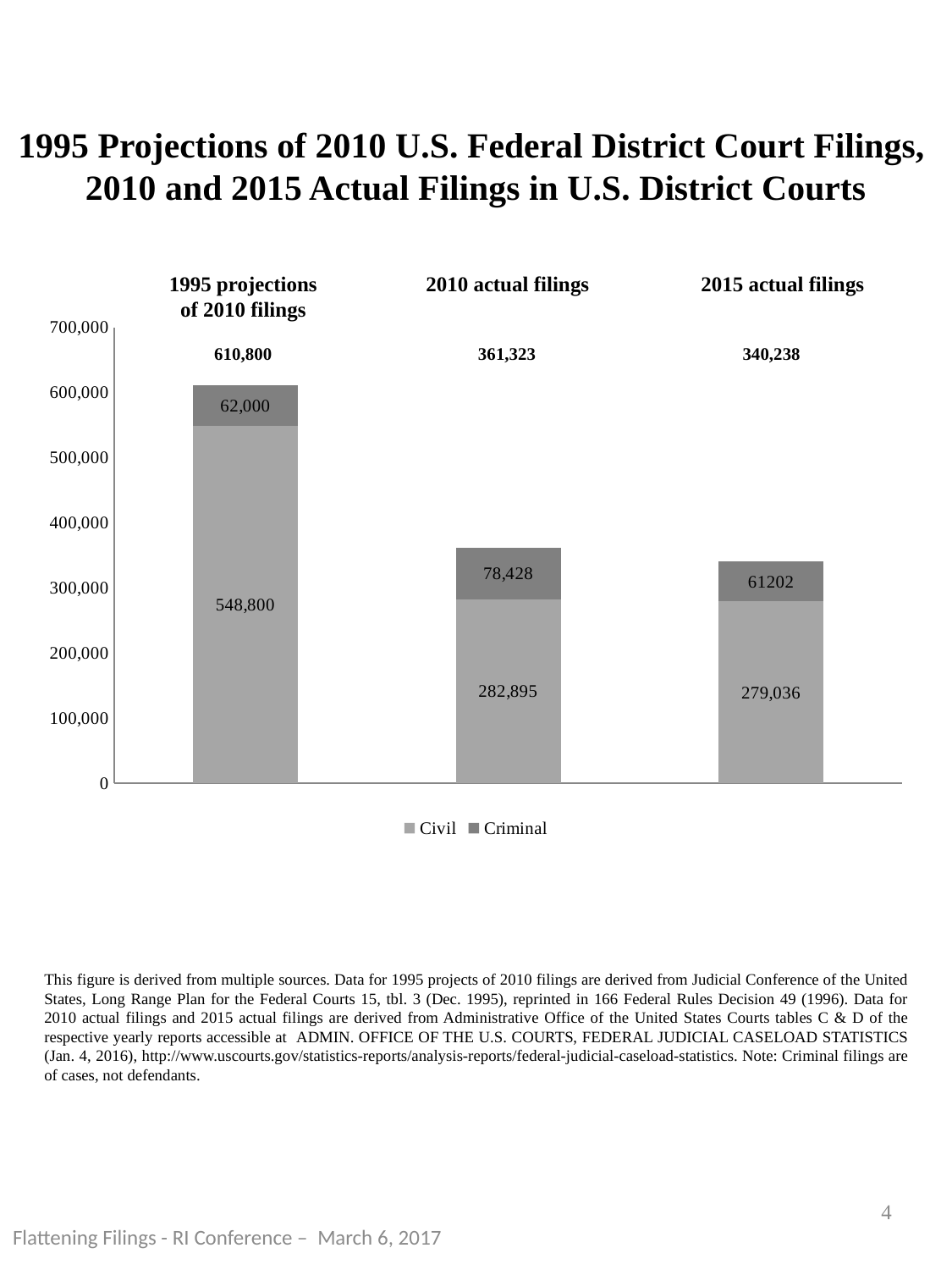
What is the Civil value for the 1995 projections of 2010 filings? 548,800 How many series does the legend list? 2 What is the total of the stacked bar for 2010 actual filings? 361,323 What is the difference between the Civil values for 2010 actual filings and 2015 actual filings? 3,859 What is the Civil value for 2015 actual filings? 279,036 What is the Criminal value for 2010 actual filings? 78,428 Which category has the highest Civil value? 1995 projections of 2010 filings How many categories are shown on the x axis? 3 What is the total of the stacked bar for 2015 actual filings? 340,238 What kind of chart is shown on the slide? Stacked bar chart Which category has the lowest Criminal value? 2015 actual filings Which is larger, the Criminal value for 1995 projections of 2010 filings or for 2010 actual filings? 2010 actual filings